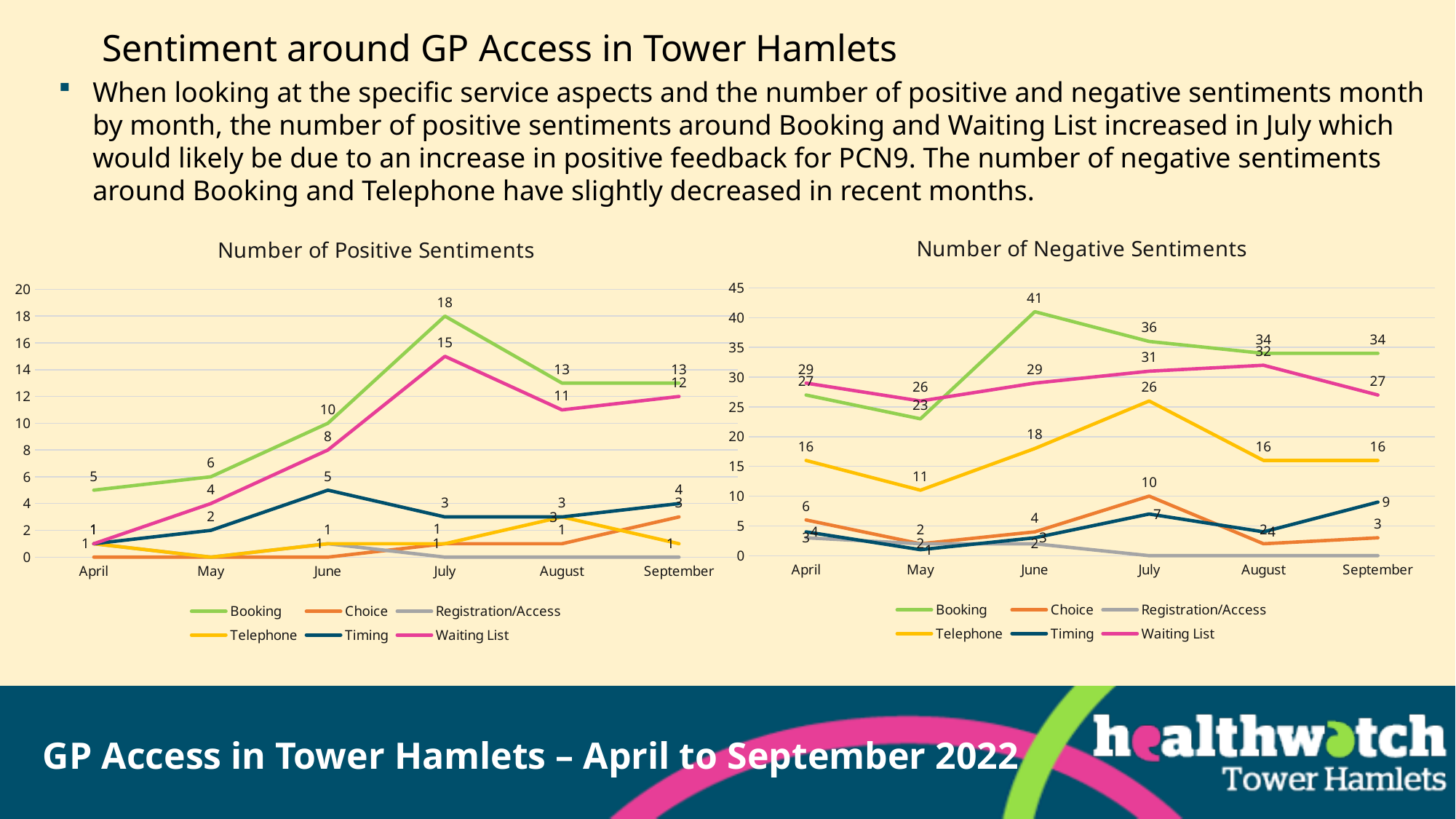
In the Number of Positive Sentiments chart, what is the difference between Booking and Waiting List in July? 3 In the Number of Positive Sentiments chart, what is the value for Waiting List in June? 8 How many series does the legend of the Number of Negative Sentiments chart list? 6 In the Number of Negative Sentiments chart, in which month is Booking at its lowest? May In the Number of Negative Sentiments chart, what is the difference between Booking and Waiting List in June? 12 In the Number of Negative Sentiments chart, what is the value for Booking in June? 41 In the Number of Positive Sentiments chart, in which month does Booking reach its highest value? July In the Number of Negative Sentiments chart, what is the value for Telephone in July? 26 In the Number of Positive Sentiments chart, does the Booking line rise or fall from April to July? rise In the Number of Negative Sentiments chart, which is larger in April, Booking or Waiting List? Waiting List What kind of chart is the Number of Positive Sentiments chart? line chart In the Number of Positive Sentiments chart, what is the value for Booking in July? 18